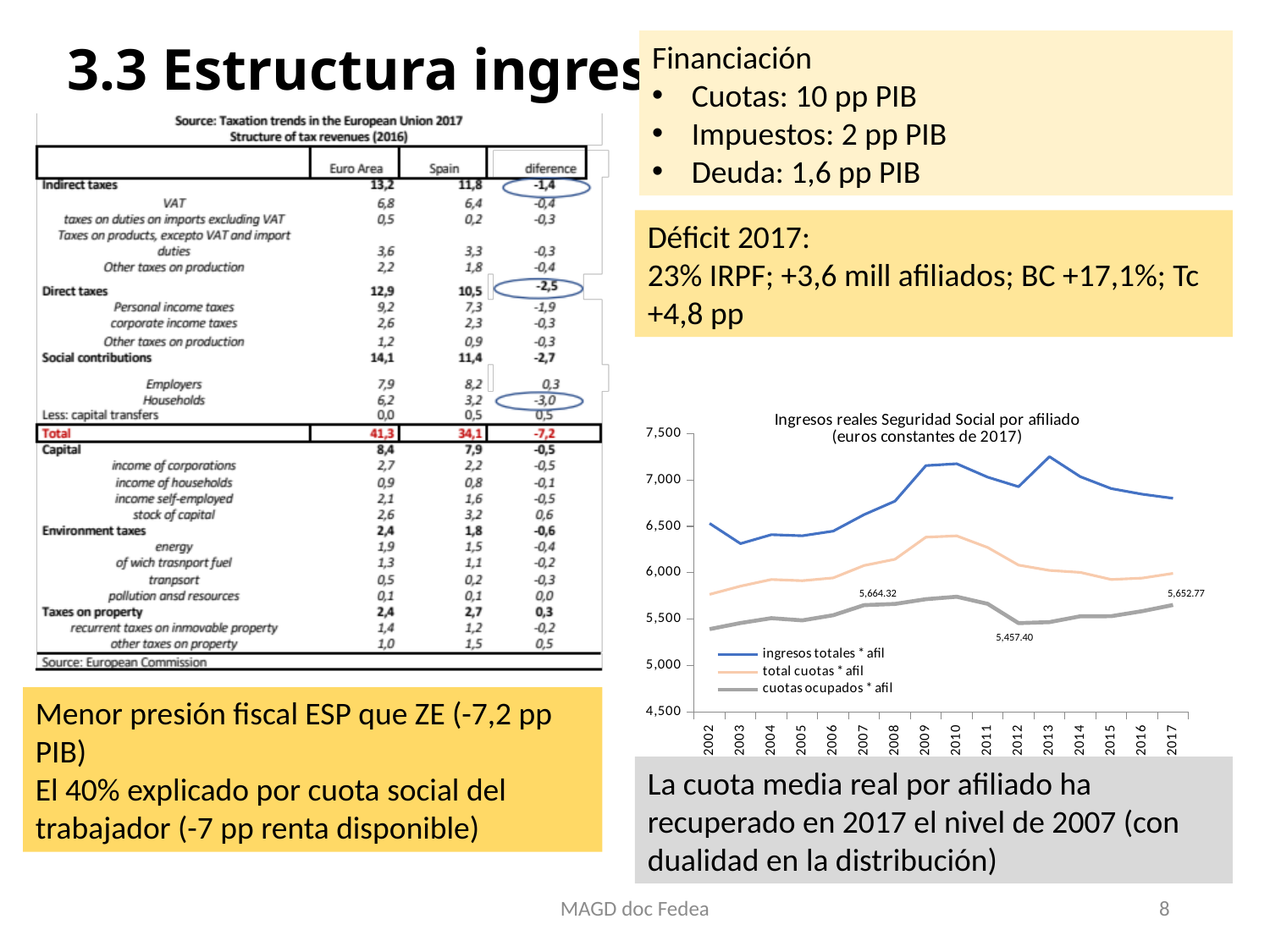
What type of chart is shown on the slide? line chart What is the title of the chart on the slide? Ingresos reales Seguridad Social por afiliado (euros constantes de 2017) Which series has the highest values throughout the chart? ingresos totales * afil How many years are plotted along the x axis of the chart? 16 By how much did 'cuotas ocupados * afil' increase from 2012 to 2017? 195.37 What is the value of 'cuotas ocupados * afil' in 2017? 5,652.77 What is the value of 'cuotas ocupados * afil' in 2012? 5,457.40 Is the value of 'total cuotas * afil' in 2002 greater or less than 6,000? less How many series does the chart's legend list? 3 Is the value of 'ingresos totales * afil' in 2013 greater or less than 7,000? greater